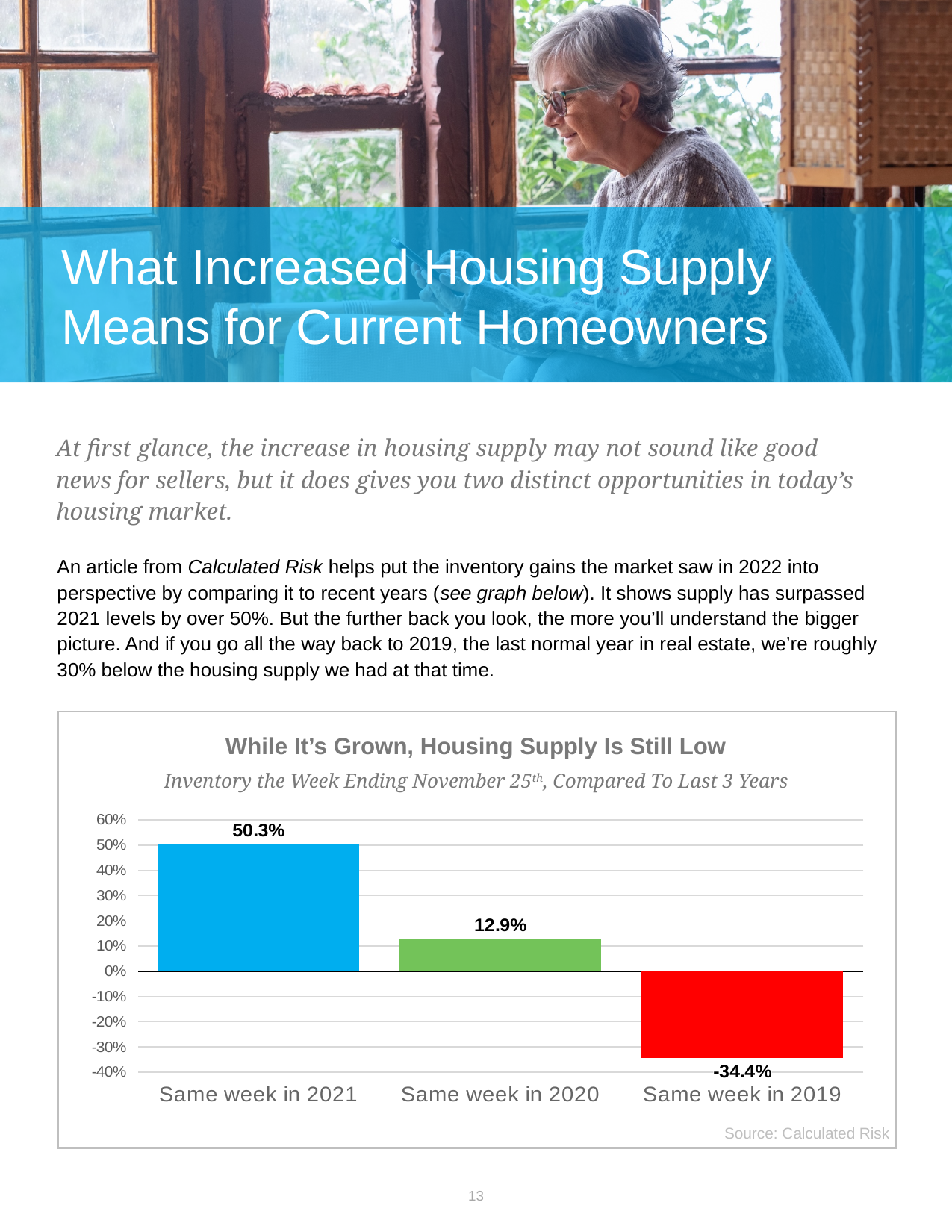
Which category has the highest value? Same week in 2021 What is the value for Same week in 2021? 50.3% What kind of chart is shown? Bar chart How many categories are shown in the chart? 3 What is the value for Same week in 2019? -34.4% What is the title of the chart? While It's Grown, Housing Supply Is Still Low What is the difference between the values for Same week in 2021 and Same week in 2020? 37.4% Which is larger, the value for Same week in 2020 or Same week in 2019? Same week in 2020 What is the value for Same week in 2020? 12.9% Is the value for Same week in 2021 greater or less than 40%? greater Do the values rise or fall moving from left to right along the x axis? Fall Which category has the lowest value? Same week in 2019